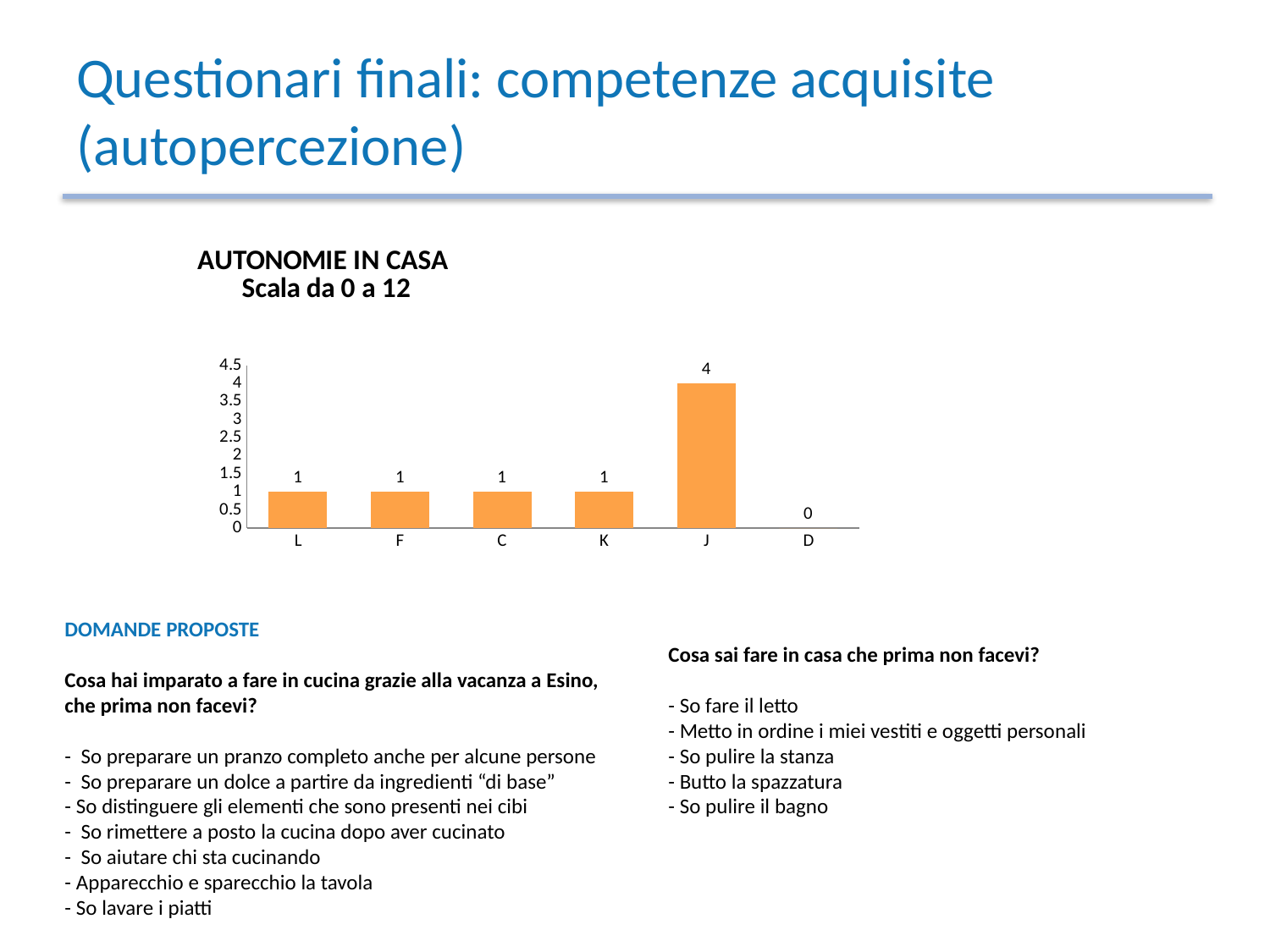
What kind of chart is shown on the slide? bar chart Which is larger, the value for J or the value for C? J Is the value for J greater or less than 3? greater How many categories are shown on the x axis? 6 What is the title of the chart? AUTONOMIE IN CASA Scala da 0 a 12 What is the value for D? 0 How many categories have a value of 1? 4 What is the value for L? 1 What is the difference between the values for J and K? 3 Which category has the lowest value? D What is the value for J? 4 Which category has the highest value? J